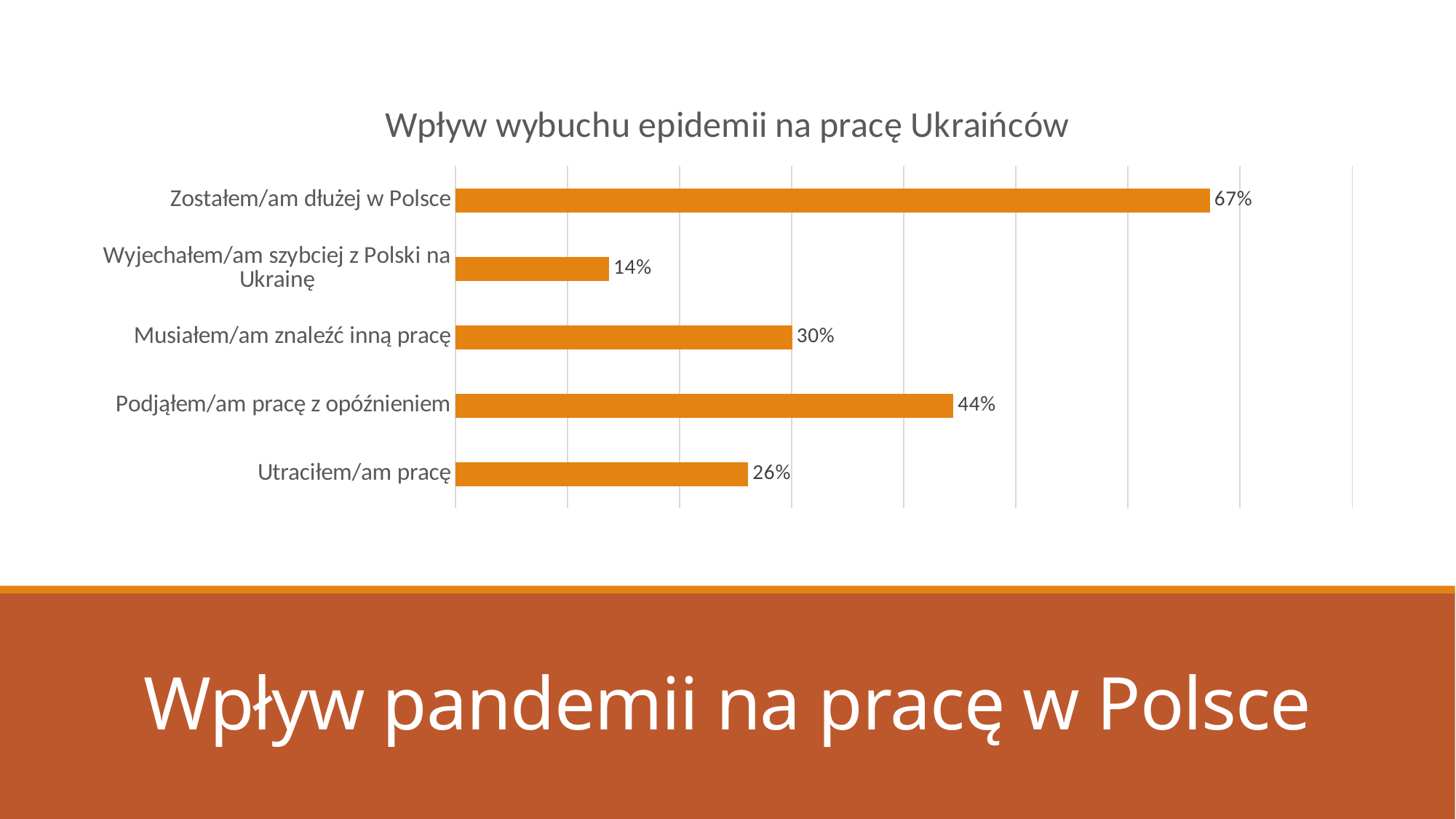
What is the title of the chart? Wpływ wybuchu epidemii na pracę Ukraińców Which category has the highest value? Zostałem/am dłużej w Polsce What is the difference between the values for "Zostałem/am dłużej w Polsce" and "Wyjechałem/am szybciej z Polski na Ukrainę"? 53% How many categories are shown in the chart? 5 What is the value for "Zostałem/am dłużej w Polsce"? 67% What is the value for "Podjąłem/am pracę z opóźnieniem"? 44% What is the value for "Musiałem/am znaleźć inną pracę"? 30% Which category has the lowest value? Wyjechałem/am szybciej z Polski na Ukrainę What is the value for "Utraciłem/am pracę"? 26% What kind of chart is shown on the slide? Bar chart Which is larger: the value for "Musiałem/am znaleźć inną pracę" or the value for "Utraciłem/am pracę"? Musiałem/am znaleźć inną pracę What is the difference between the values for "Podjąłem/am pracę z opóźnieniem" and "Utraciłem/am pracę"? 18%